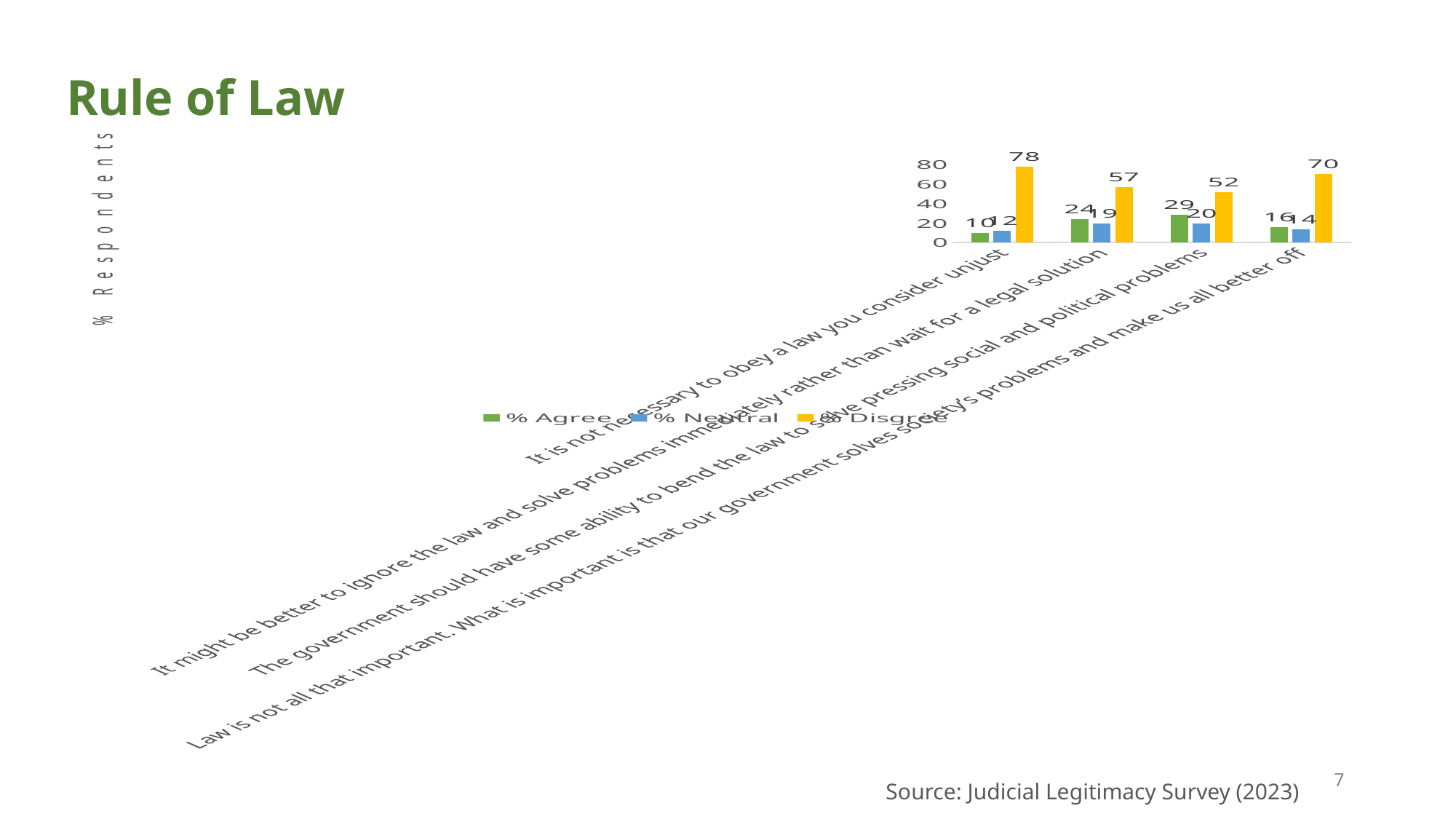
What is the % Disagree value for the statement 'Law is not all that important. What is important is that our government solves society's problems and make us all better off'? 70 What is the difference between the % Disagree values for 'It is not necessary to obey a law you consider unjust' and 'It might be better to ignore the law and solve problems immediately rather than wait for a legal solution'? 21 What is the % Neutral value for the statement 'It might be better to ignore the law and solve problems immediately rather than wait for a legal solution'? 19 How many series does the legend list? 3 What is the label on the vertical axis of the chart? % Respondents Which statement has the lowest % Agree value? It is not necessary to obey a law you consider unjust What is the % Agree value for the statement 'The government should have some ability to bend the law to solve pressing social and political problems'? 29 Which statement has the highest % Disagree value? It is not necessary to obey a law you consider unjust Which is larger: the % Agree value for 'The government should have some ability to bend the law to solve pressing social and political problems' or the % Agree value for 'Law is not all that important. What is important is that our government solves society's problems and make us all better off'? The government should have some ability to bend the law to solve pressing social and political problems How many statements (categories) are plotted on the chart? 4 What kind of chart is shown on the slide? bar chart What is the % Disagree value for the statement 'It is not necessary to obey a law you consider unjust'? 78